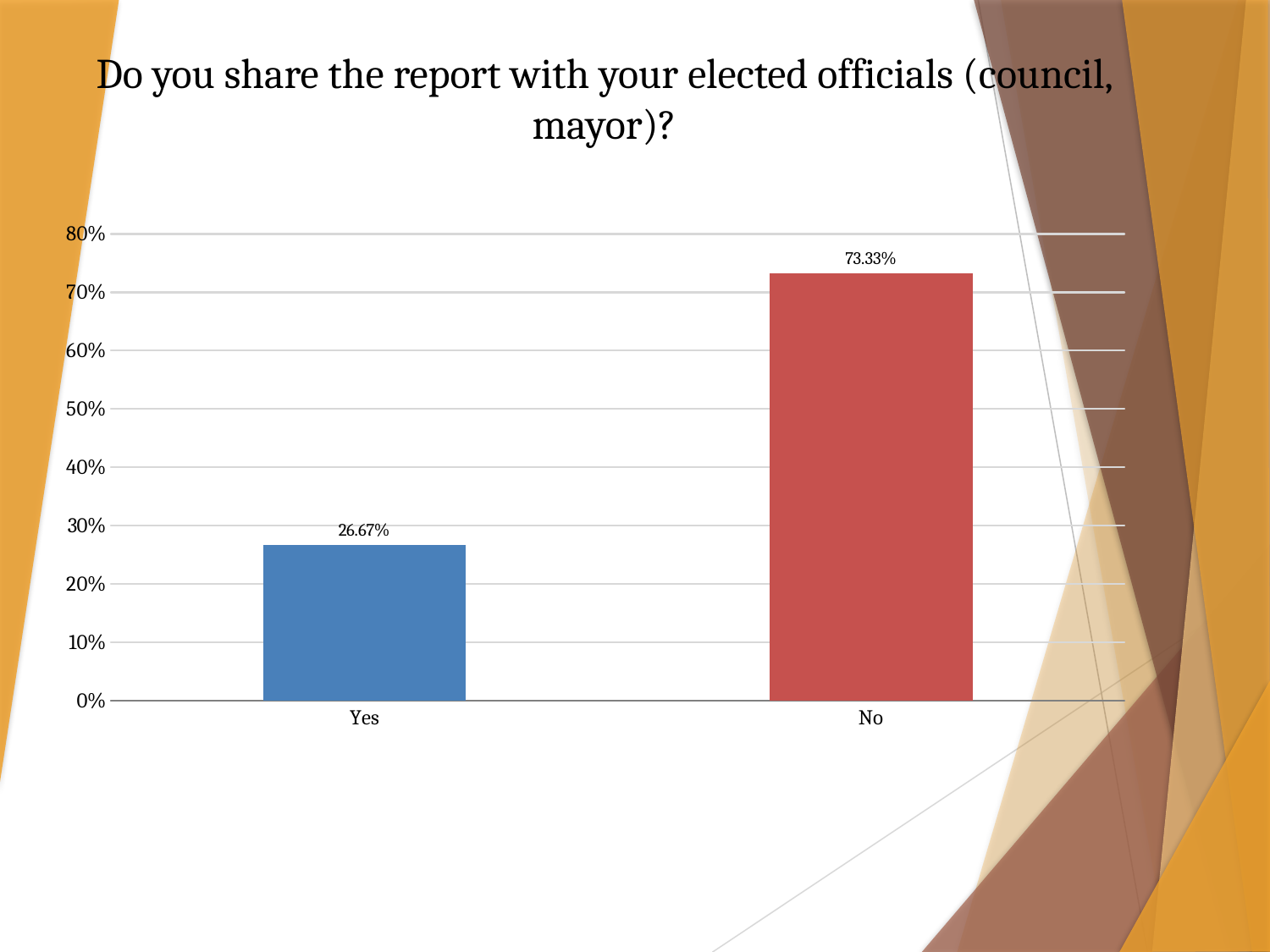
Is the value for No greater or less than 70%? greater Which response has the lowest percentage? Yes What colour is the bar for the No response? red What percentage of respondents answered Yes? 26.67% Which response has the highest percentage? No What kind of chart is shown on the slide? bar chart What is the title of the chart? Do you share the report with your elected officials (council, mayor)? Which is larger, the value for Yes or the value for No? No How many response categories are shown on the chart? 2 What is the difference in percentage points between the No and Yes responses? 46.66 Is the value for Yes greater or less than 30%? less What percentage of respondents answered No? 73.33%